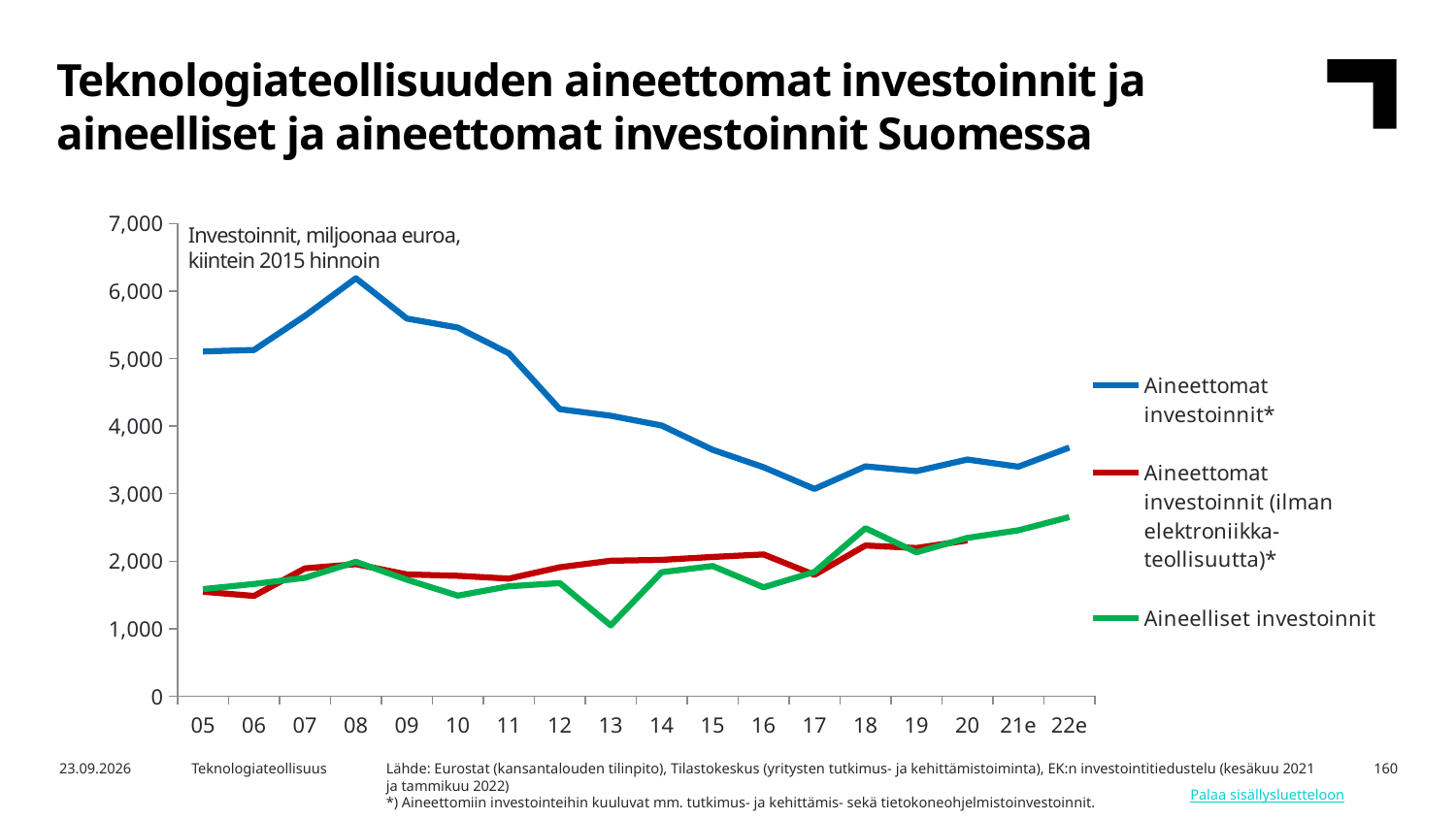
In which year does the Aineelliset investoinnit series reach its lowest value? 13 Is the value for Aineettomat investoinnit* in 08 greater or less than 6,000? greater What kind of chart is shown on the slide? line chart What unit is stated in the text box inside the chart? Investoinnit, miljoonaa euroa, kiintein 2015 hinnoin How many points are plotted along the x axis (from 05 to 22e)? 18 Which series has the higher value in 05: Aineettomat investoinnit* or Aineelliset investoinnit? Aineettomat investoinnit* In which year does the Aineettomat investoinnit* series reach its highest value? 08 Is the value for Aineelliset investoinnit in 13 greater or less than 2,000? less Does the Aineettomat investoinnit* series rise or fall from 08 to 17? fall Is the value for Aineettomat investoinnit* in 17 greater or less than 4,000? less Does the Aineelliset investoinnit series rise or fall from 13 to 22e? rise How many series does the legend list? 3